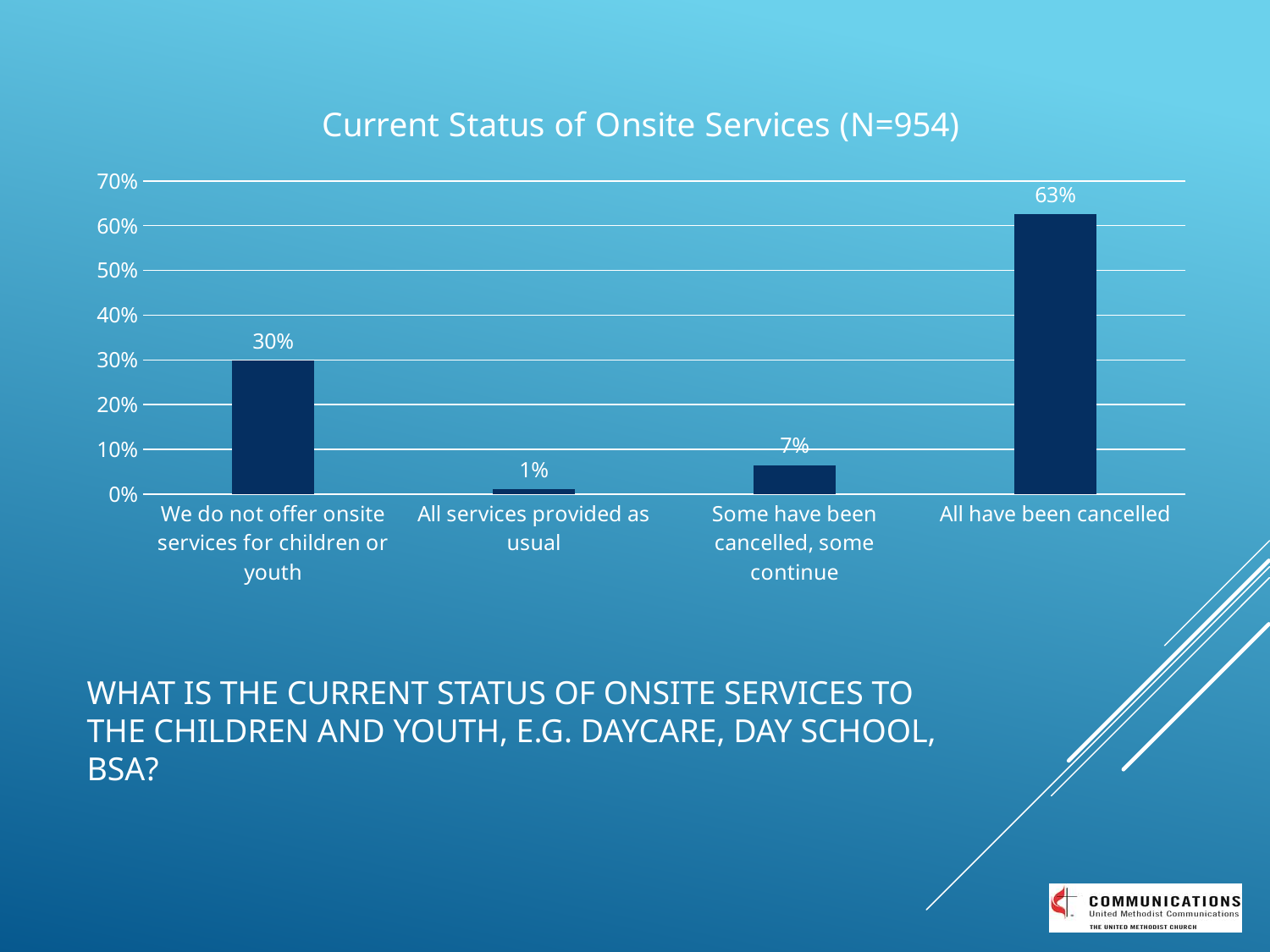
Which category has the highest value? All have been cancelled Is the value for "All have been cancelled" greater or less than 50%? greater What is the difference between "All have been cancelled" and "We do not offer onsite services for children or youth"? 33% What is the value for "All services provided as usual"? 1% What is the value for "We do not offer onsite services for children or youth"? 30% What is the value for "All have been cancelled"? 63% How many categories are shown in the chart? 4 Which is larger: "Some have been cancelled, some continue" or "All services provided as usual"? Some have been cancelled, some continue Which category has the lowest value? All services provided as usual What kind of chart is shown on the slide? Bar chart What is the title of the chart? Current Status of Onsite Services (N=954) What is the value for "Some have been cancelled, some continue"? 7%